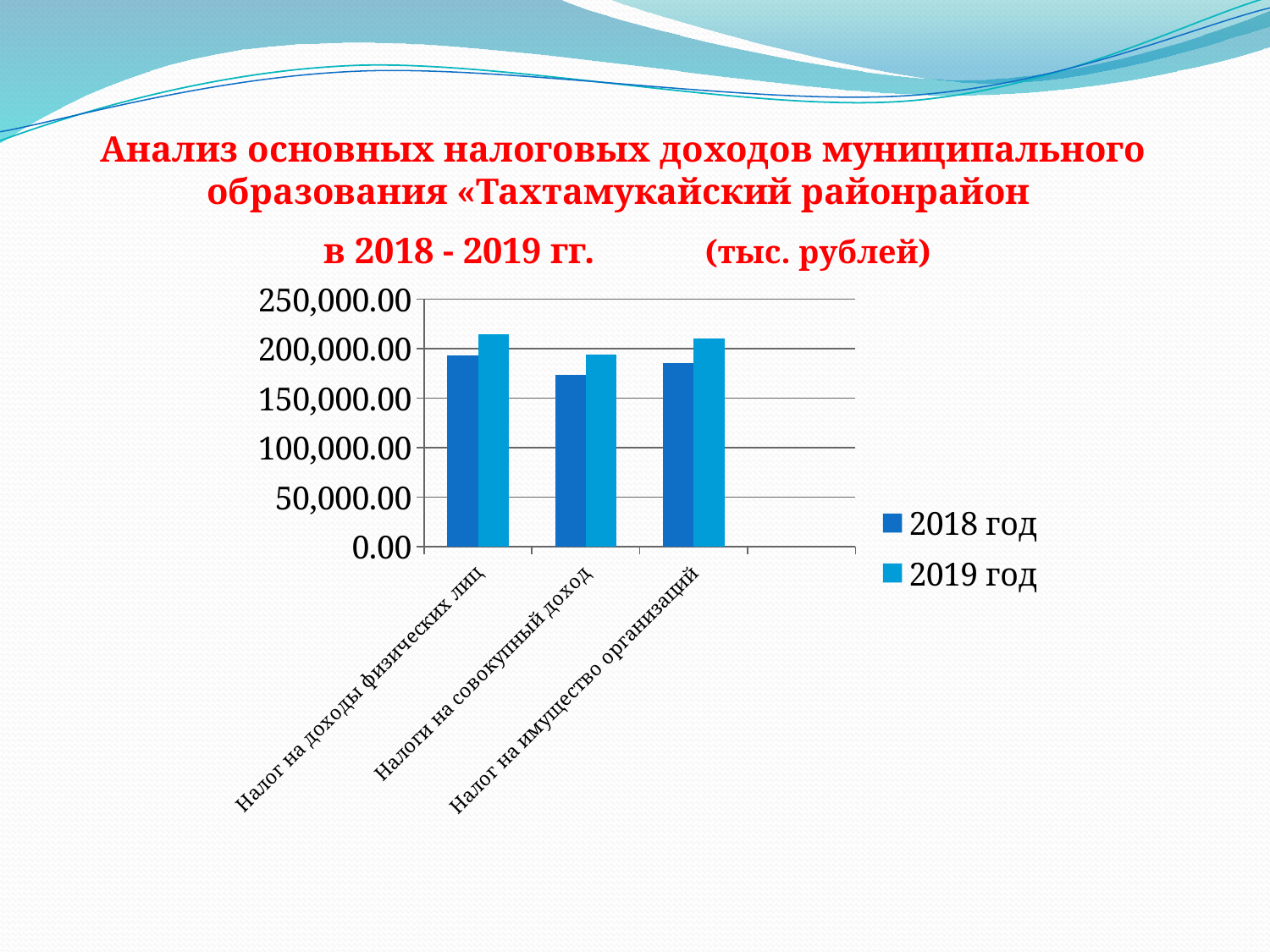
How many series does the legend list? 2 What kind of chart is shown on the slide? bar chart Is the 2019 год value for Налог на имущество организаций greater or less than 200,000.00? greater Is the 2018 год value for Налог на имущество организаций greater or less than 150,000.00? greater Is the 2019 год value for Налог на доходы физических лиц greater or less than 200,000.00? greater Which category has the lowest value for 2019 год? Налоги на совокупный доход For Налог на имущество организаций, which year has the larger value, 2018 год or 2019 год? 2019 год Which category has the lowest value for 2018 год? Налоги на совокупный доход How many tax categories are shown on the x axis? 3 For Налоги на совокупный доход, which year has the larger value, 2018 год or 2019 год? 2019 год What are the two series named in the legend? 2018 год and 2019 год